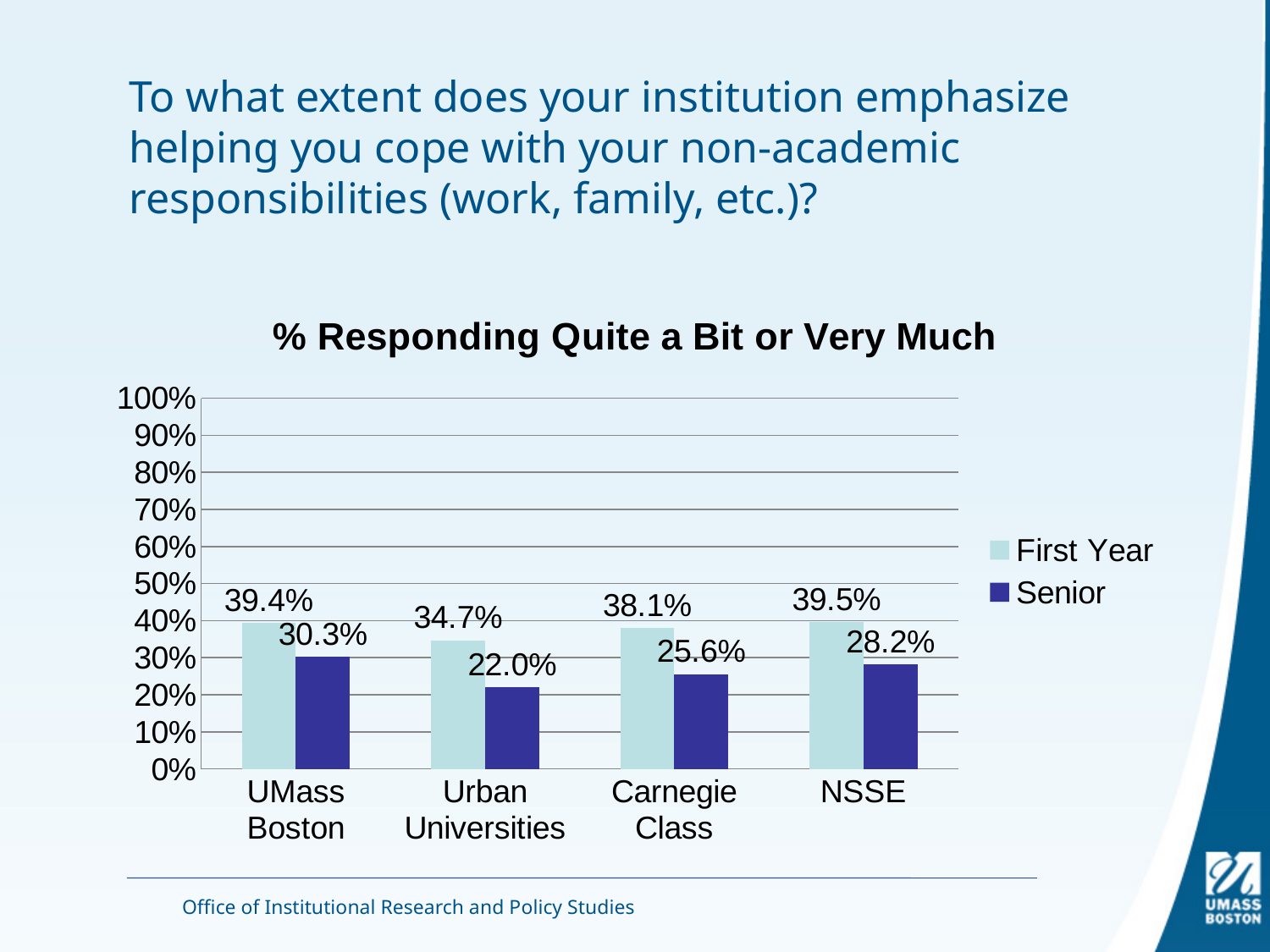
Which is larger, the Senior value for Carnegie Class or the Senior value for NSSE? NSSE Which category has the highest Senior value? UMass Boston What is the First Year value for UMass Boston? 39.4% Is the Senior value for Urban Universities greater or less than 30%? less What is the difference between the First Year and Senior values for UMass Boston? 9.1 percentage points Which category has the lowest First Year value? Urban Universities What kind of chart is shown on the slide? bar chart How many categories are shown on the x axis? 4 What is the Senior value for Carnegie Class? 25.6% What is the Senior value for Urban Universities? 22.0% How many series does the legend list? 2 What is the First Year value for NSSE? 39.5%